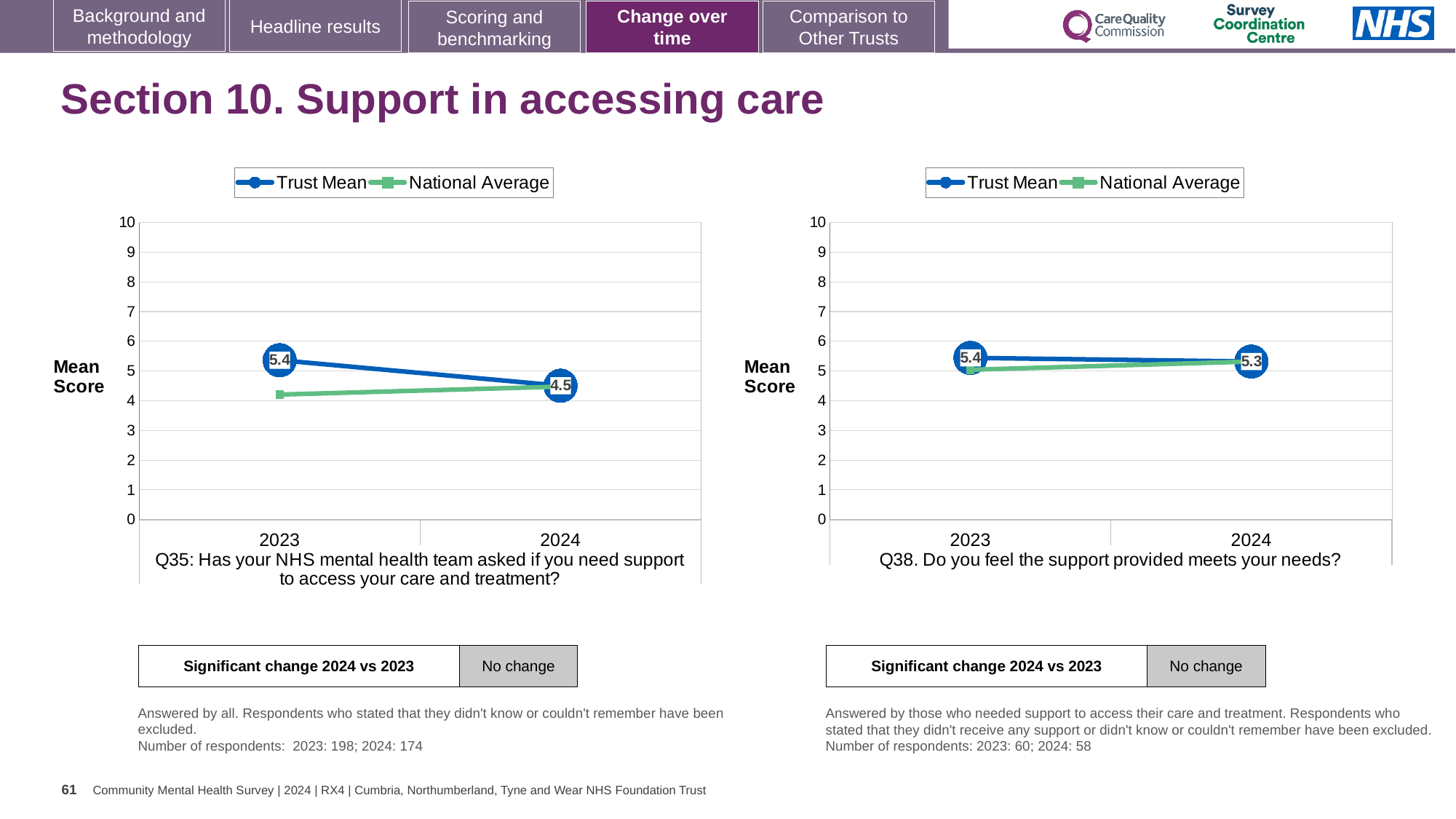
In the Q35 chart (left), what is the Trust Mean for 2023? 5.4 In the Q38 chart (right), what is the Trust Mean for 2023? 5.4 How many series does the legend of the Q38 chart (right) list? 2 In the Q35 chart (left), what is the Trust Mean for 2024? 4.5 In the Q38 chart (right), what is the Trust Mean for 2024? 5.3 In the Q35 chart (left), is the National Average for 2023 greater or less than 5? less What kind of chart is the Q38 chart (right)? line chart In the Q35 chart (left), by how much did the Trust Mean fall from 2023 to 2024? 0.9 In the Q35 chart (left), which is larger in 2023, the Trust Mean or the National Average? Trust Mean How many years are plotted on the x axis of the Q35 chart (left)? 2 In the Q35 chart (left), does the Trust Mean rise or fall from 2023 to 2024? fall In the Q38 chart (right), is the National Average for 2023 greater or less than 6? less